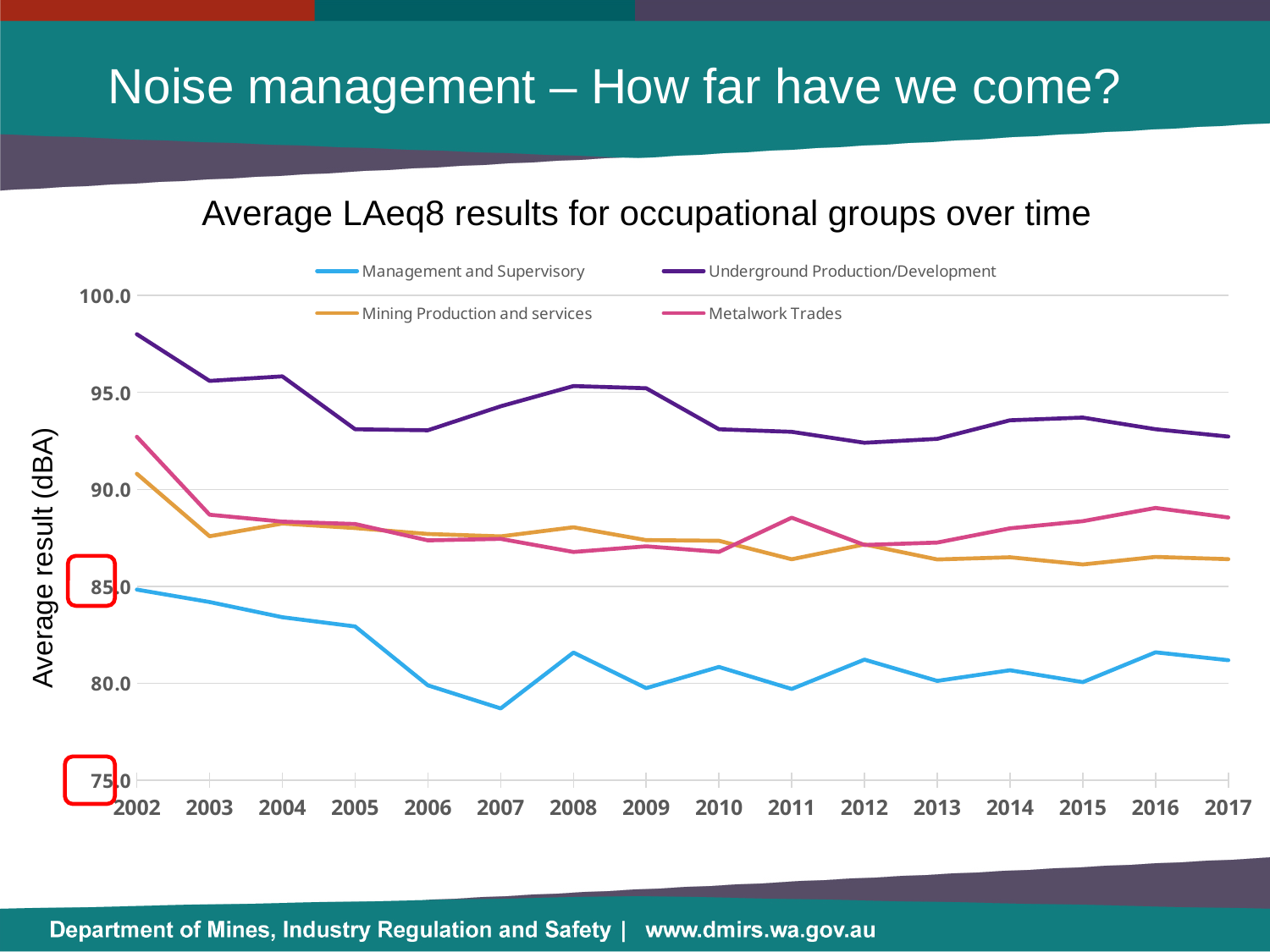
In which year is the Underground Production/Development line at its highest? 2002 Is the value for Underground Production/Development in 2002 greater or less than 95.0? greater Which occupational group has the lowest average result across all years? Management and Supervisory Does the Underground Production/Development line rise or fall overall from 2002 to 2017? Fall Is the value for Management and Supervisory in 2007 greater or less than 80.0? less What kind of chart is shown on the slide? Line chart In 2011, which is higher: Metalwork Trades or Mining Production and services? Metalwork Trades Is the value for Metalwork Trades in 2002 greater or less than 90.0? greater Which occupational group has the highest average result across all years? Underground Production/Development How many series does the legend list? 4 In which year is the Management and Supervisory line at its lowest? 2007 How many years are shown along the x axis? 16